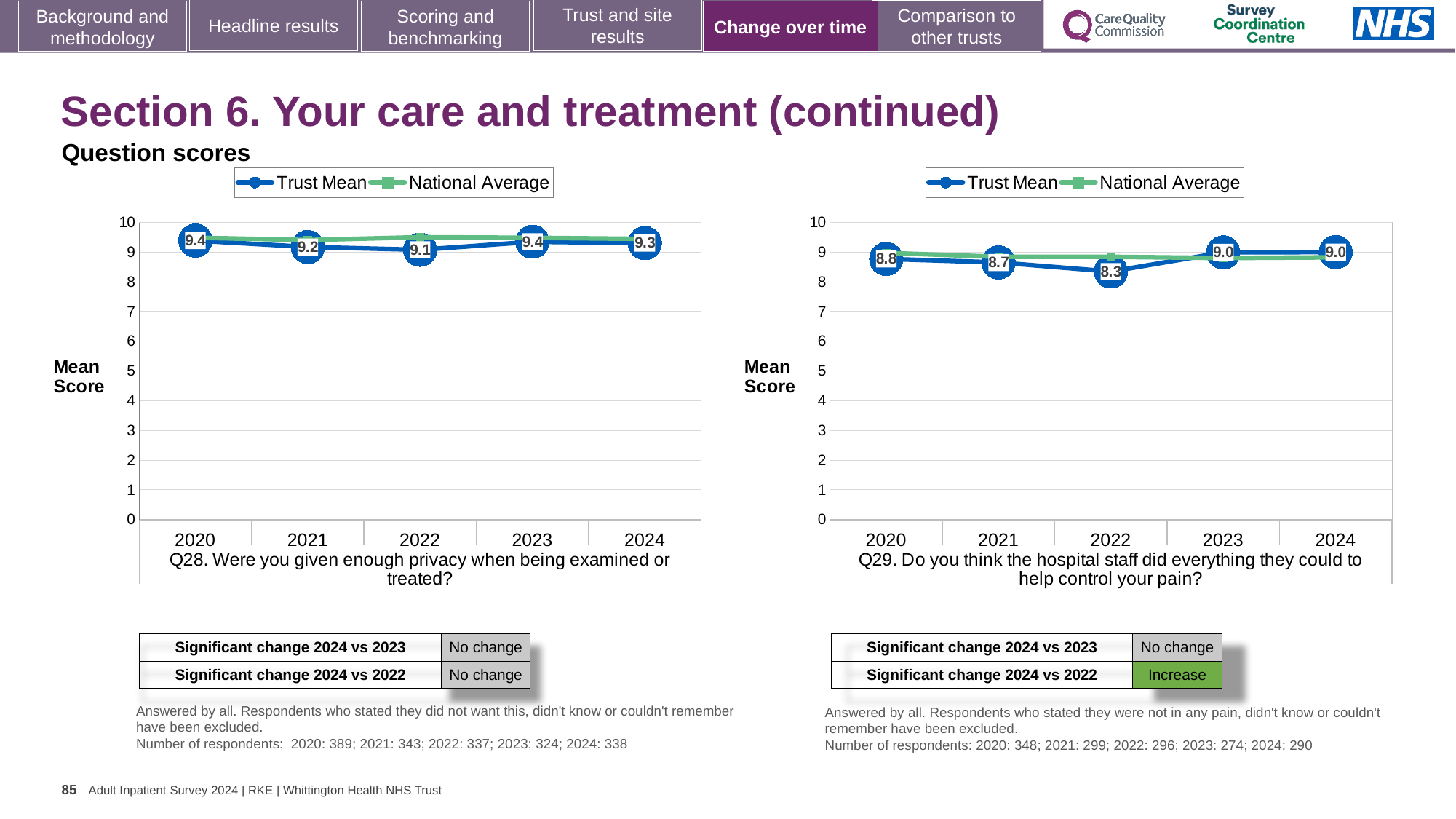
In the Q29 chart on the right, what is the difference between the Trust Mean scores for 2023 and 2022? 0.7 In the Q28 chart on the left, is the Trust Mean score higher in 2020 or in 2021? 2020 In the Q29 chart on the right, what is the Trust Mean score for 2024? 9.0 What kind of chart is the Q28 chart on the left? Line chart In the Q29 chart on the right, which year has the lowest Trust Mean score? 2022 In the Q29 chart on the right, what is the Trust Mean score for 2020? 8.8 In the Q28 chart on the left, what is the difference between the Trust Mean scores for 2023 and 2022? 0.3 In the Q28 chart on the left, which year has the lowest Trust Mean score? 2022 In the Q29 chart on the right, is the National Average value for 2020 greater or less than 8? greater In the Q28 chart on the left, what is the Trust Mean score for 2022? 9.1 How many series does the legend of the Q29 chart on the right list? 2 How many years are plotted on the x axis of the Q28 chart on the left? 5